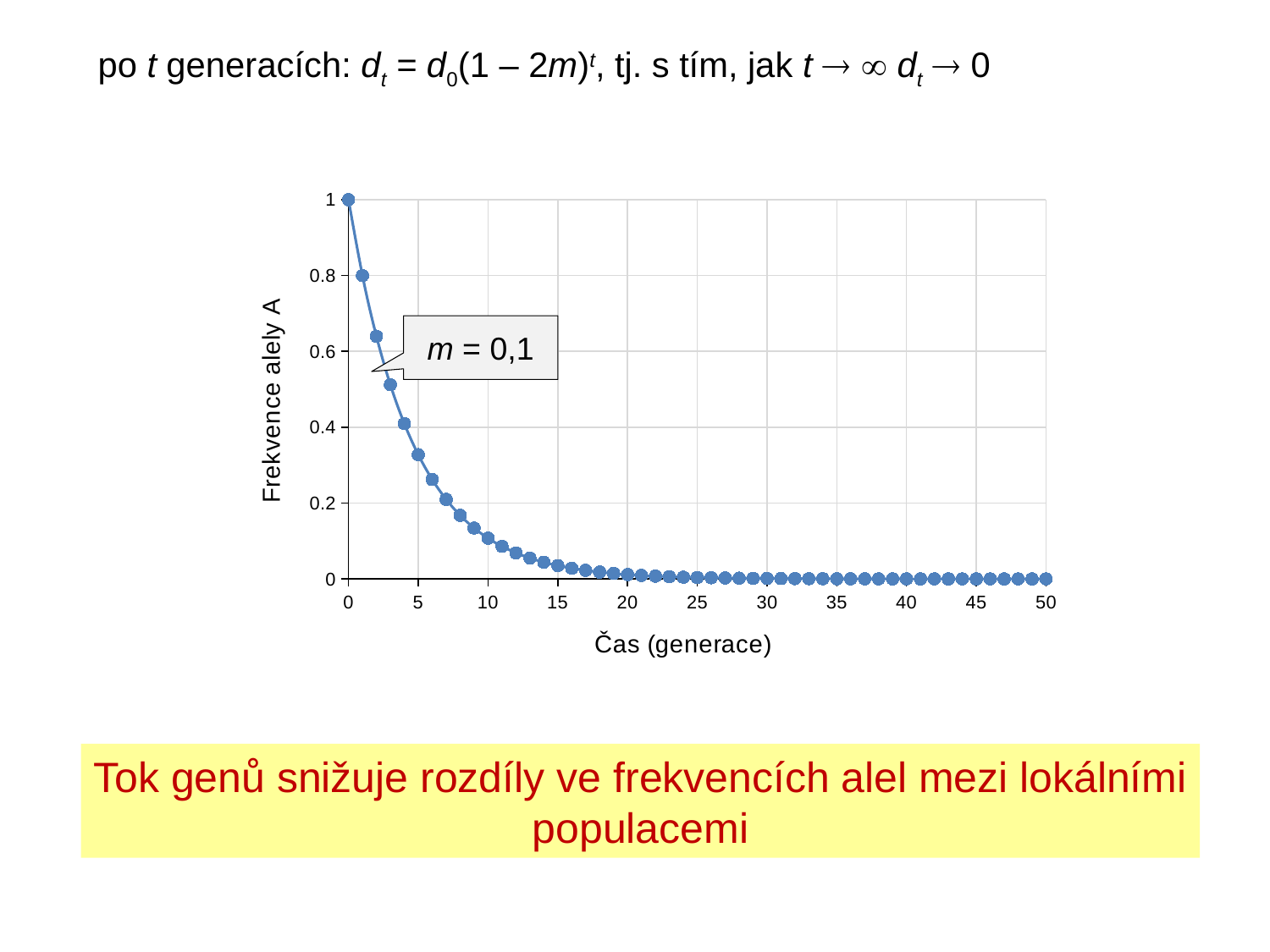
Is the value for generation 10 greater or less than 0.2? less What is the label of the x axis? Čas (generace) Do the values rise or fall as time (generations) increases along the x axis? fall What is the value of Frekvence alely A at generation 1? 0.8 What kind of chart is shown on the slide? line chart What is the value of Frekvence alely A at generation 0? 1 At which generation is Frekvence alely A highest? 0 Is the value for generation 5 greater or less than 0.4? less Which is larger, the value at generation 2 or the value at generation 8? generation 2 Is the value for generation 3 greater or less than 0.4? greater What value of m is given in the callout on the chart? m = 0,1